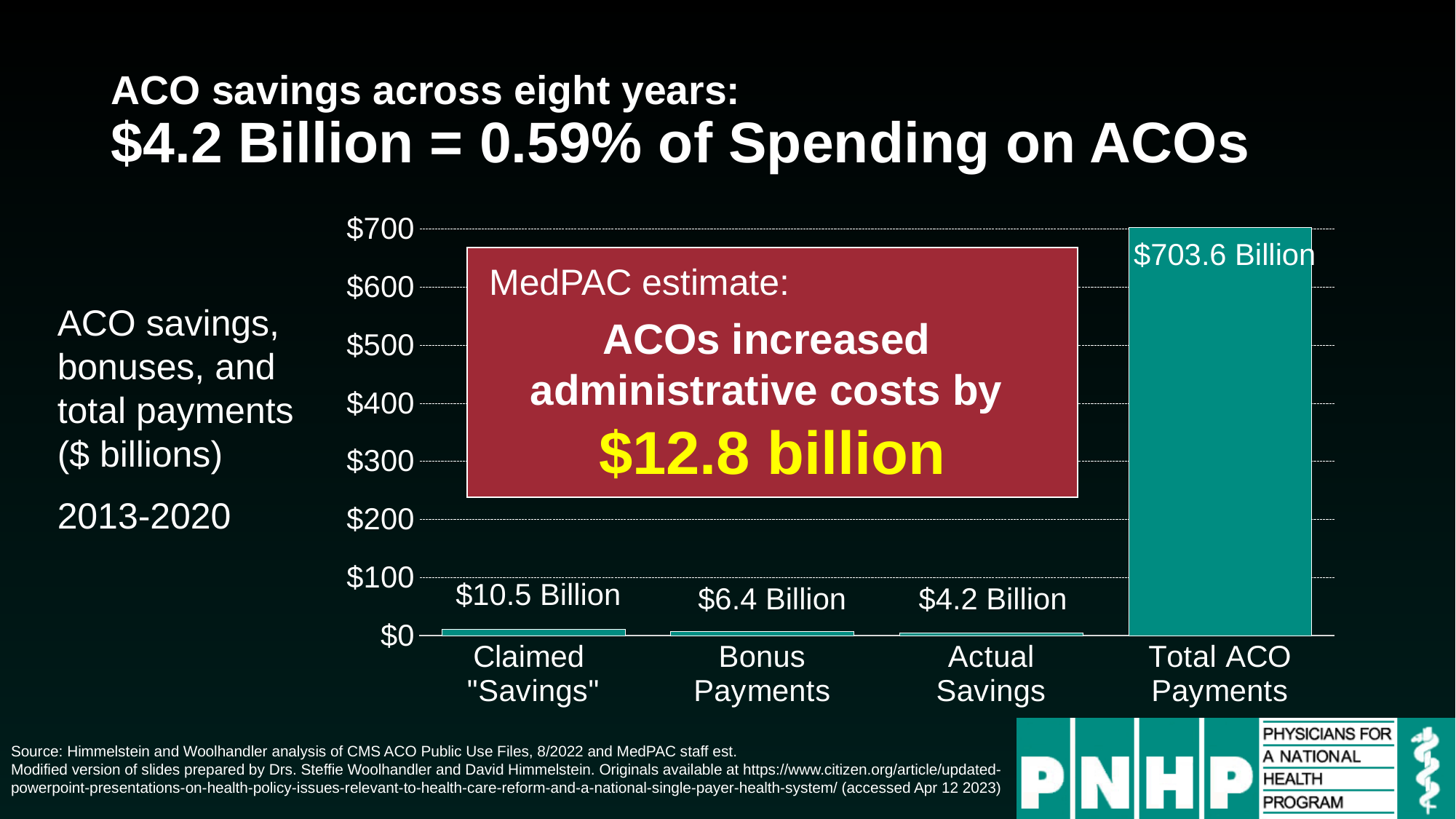
What is the value for Total ACO Payments? $703.6 Billion Which is larger, Bonus Payments or Actual Savings? Bonus Payments Which category has the highest value? Total ACO Payments What is the value for Bonus Payments? $6.4 Billion What kind of chart is shown on the slide? bar chart Which category has the lowest value? Actual Savings How many categories are shown on the x axis? 4 According to the red box on the chart, by how much did ACOs increase administrative costs per the MedPAC estimate? $12.8 billion Is the value for Total ACO Payments greater or less than $600? greater What is the value for Actual Savings? $4.2 Billion What is the value for Claimed "Savings"? $10.5 Billion What is the difference between Claimed "Savings" and Actual Savings? $6.3 Billion